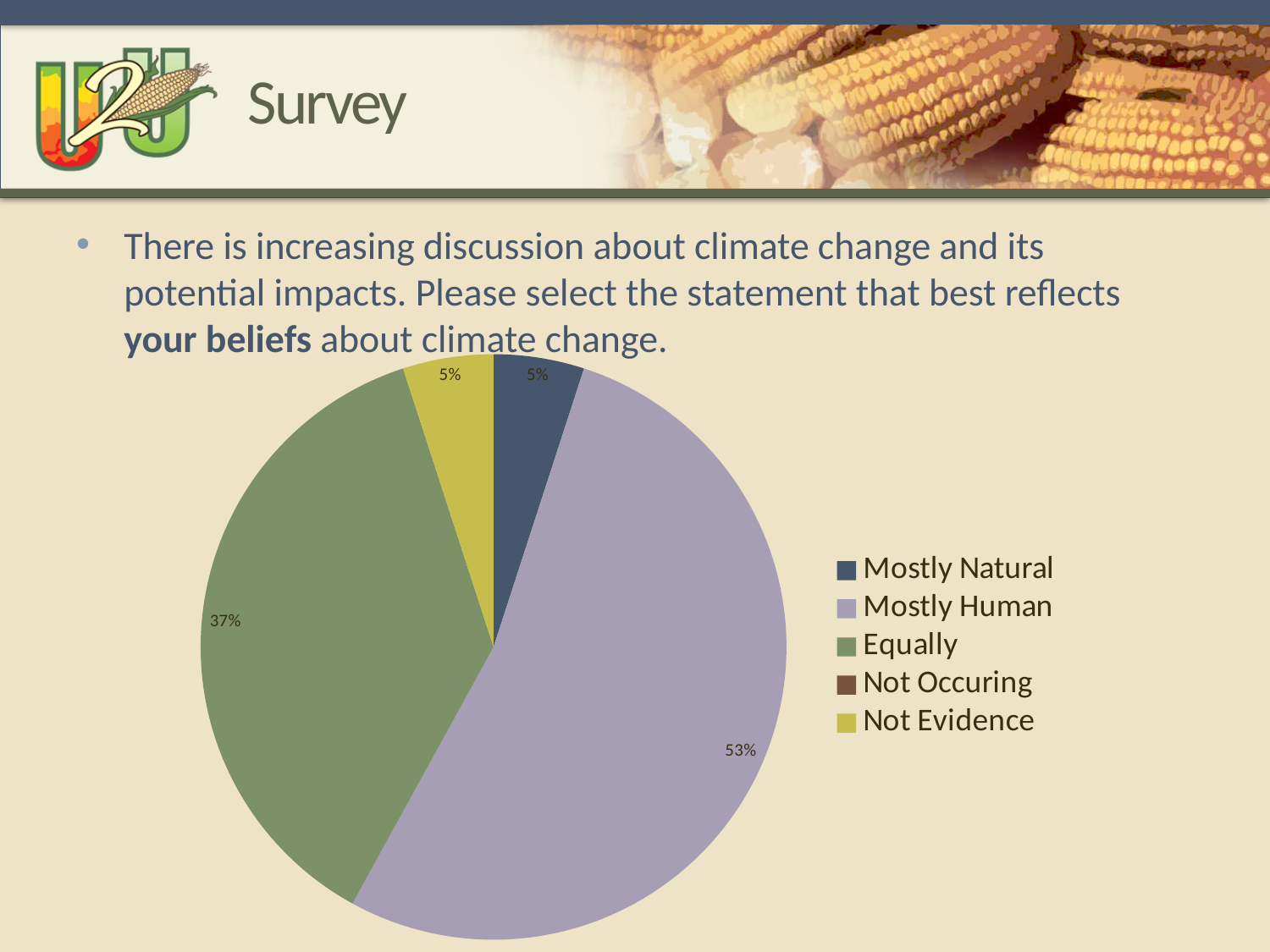
Which category has the largest slice of the pie? Mostly Human Which is larger, the share for "Mostly Human" or the share for "Equally"? Mostly Human What is the difference in percentage points between "Mostly Human" and "Equally"? 16 How many entries does the legend list? 5 What is the difference in percentage points between "Equally" and "Mostly Natural"? 32 What kind of chart is shown on the slide? pie chart What percentage of respondents selected "Equally"? 37% Which legend entry has no visible slice in the pie? Not Occuring What colour is the "Mostly Human" slice? purple What percentage of respondents selected "Not Evidence"? 5% What percentage of respondents selected "Mostly Human"? 53% What percentage of respondents selected "Mostly Natural"? 5%